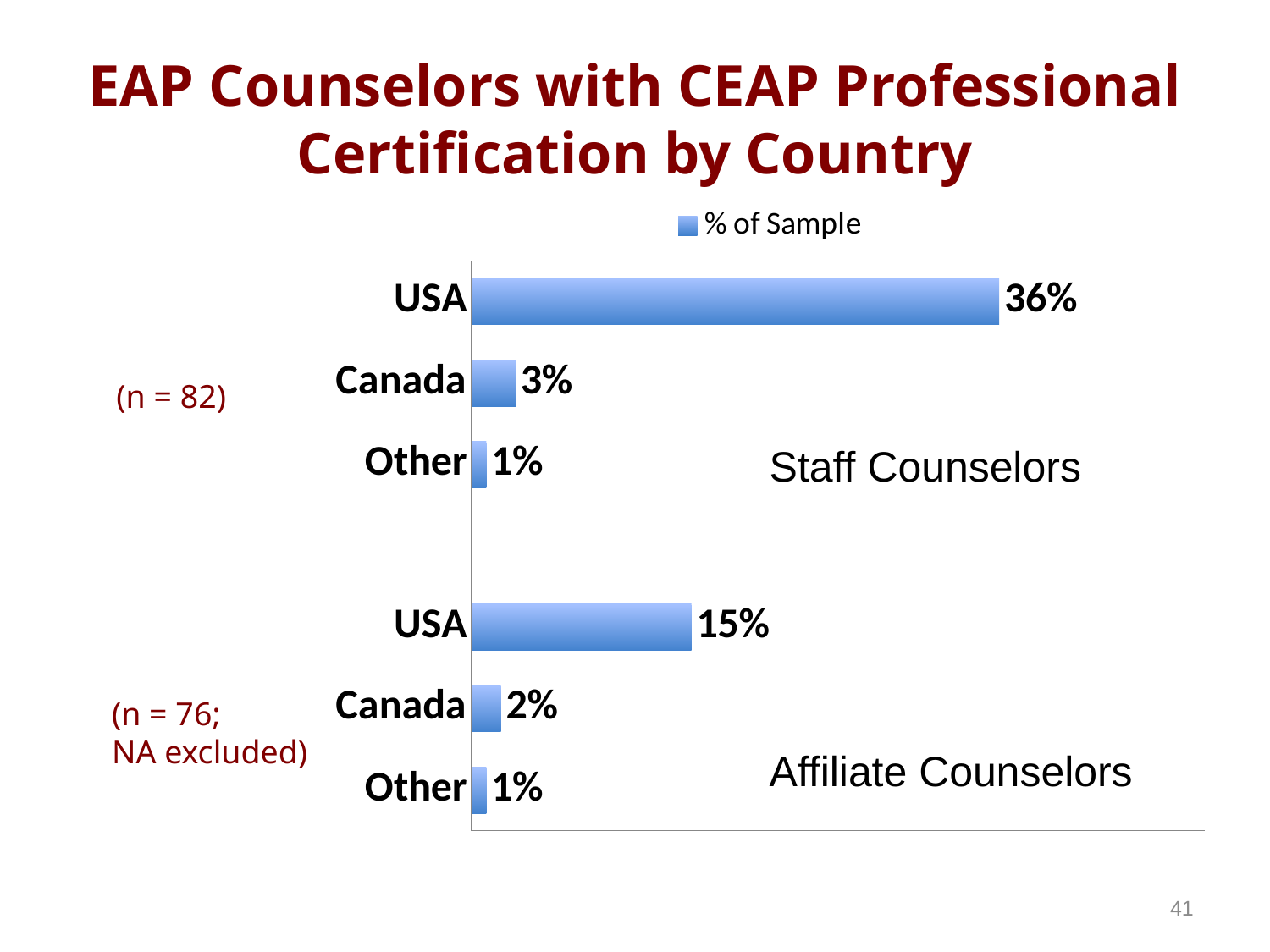
Among Affiliate Counselors, which country has the lowest value? Other What is the difference between the Canada value for Staff Counselors and the Canada value for Affiliate Counselors? 1% What is the value for Canada among Affiliate Counselors? 2% How many bars are plotted on the chart? 6 What kind of chart is shown on the slide? Bar chart What is the difference between the USA value for Staff Counselors and the USA value for Affiliate Counselors? 21% How many series does the legend list? 1 What is the value for USA among Staff Counselors? 36% Which is larger: the Canada value for Staff Counselors or the Canada value for Affiliate Counselors? Canada for Staff Counselors What is the value for USA among Affiliate Counselors? 15% Which category has the highest value on the chart? USA (Staff Counselors) What is the value for Other among Staff Counselors? 1%